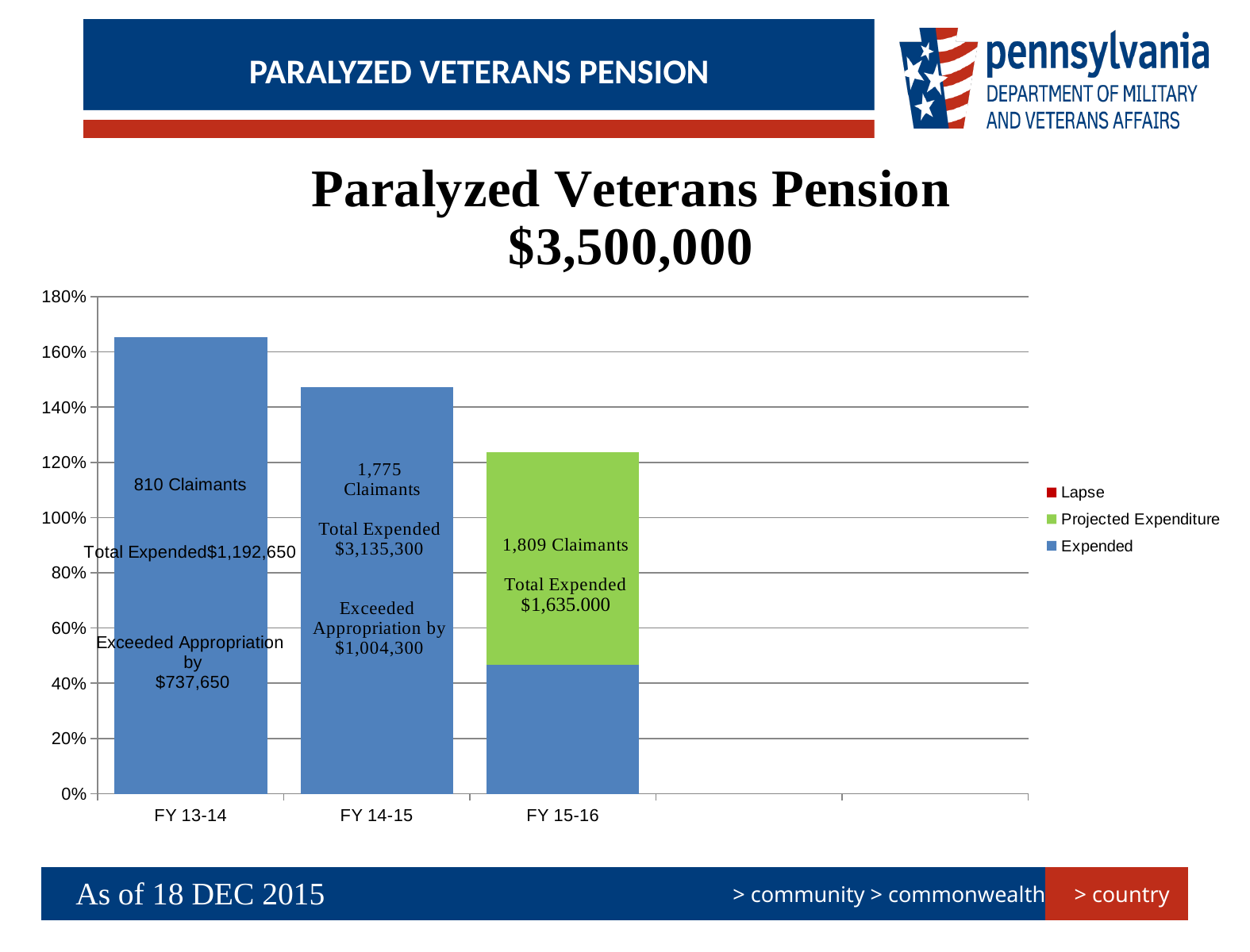
By how much did FY 13-14 exceed its appropriation, according to the chart label? $737,650 How many fiscal years are shown on the x axis of the chart? 3 How many series does the chart legend list? 3 Which fiscal year has the tallest bar in the chart? FY 13-14 How many claimants are shown for FY 13-14? 810 Claimants How many more claimants are shown for FY 14-15 than for FY 13-14? 965 Is the total bar height for FY 14-15 greater or less than 140%? greater What is the Total Expended amount shown for FY 14-15? $3,135,300 Is the Expended (blue) portion of the FY 15-16 bar greater or less than 60%? less What dollar amount appears in the chart title below 'Paralyzed Veterans Pension'? $3,500,000 What type of chart is shown on the slide? bar chart What is the Total Expended amount shown for FY 15-16? $1,635.000